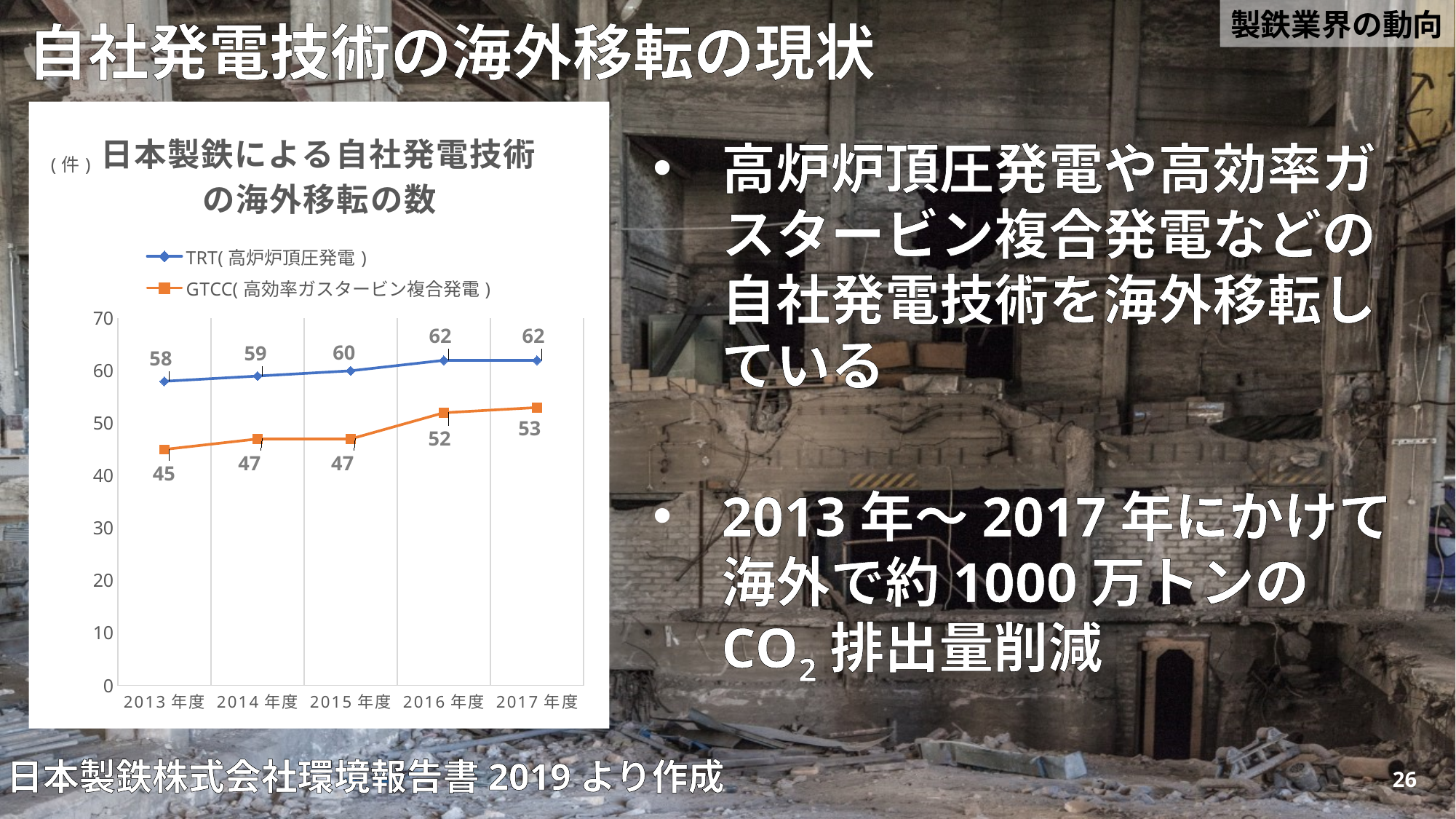
What is the GTCC value for 2017年度? 53 What is the title of the chart? 日本製鉄による自社発電技術の海外移転の数 In which year is the GTCC value lowest? 2013年度 What is the GTCC value for 2016年度? 52 Which series has the larger value in 2017年度, TRT or GTCC? TRT What is the difference between the TRT and GTCC values in 2013年度? 13 How many series does the legend list? 2 What is the TRT value for 2013年度? 58 What kind of chart is shown on the slide? Line chart Do the GTCC values rise or fall from 2013年度 to 2017年度? Rise How many years are shown on the x axis? 5 What is the difference between the GTCC values in 2015年度 and 2016年度? 5